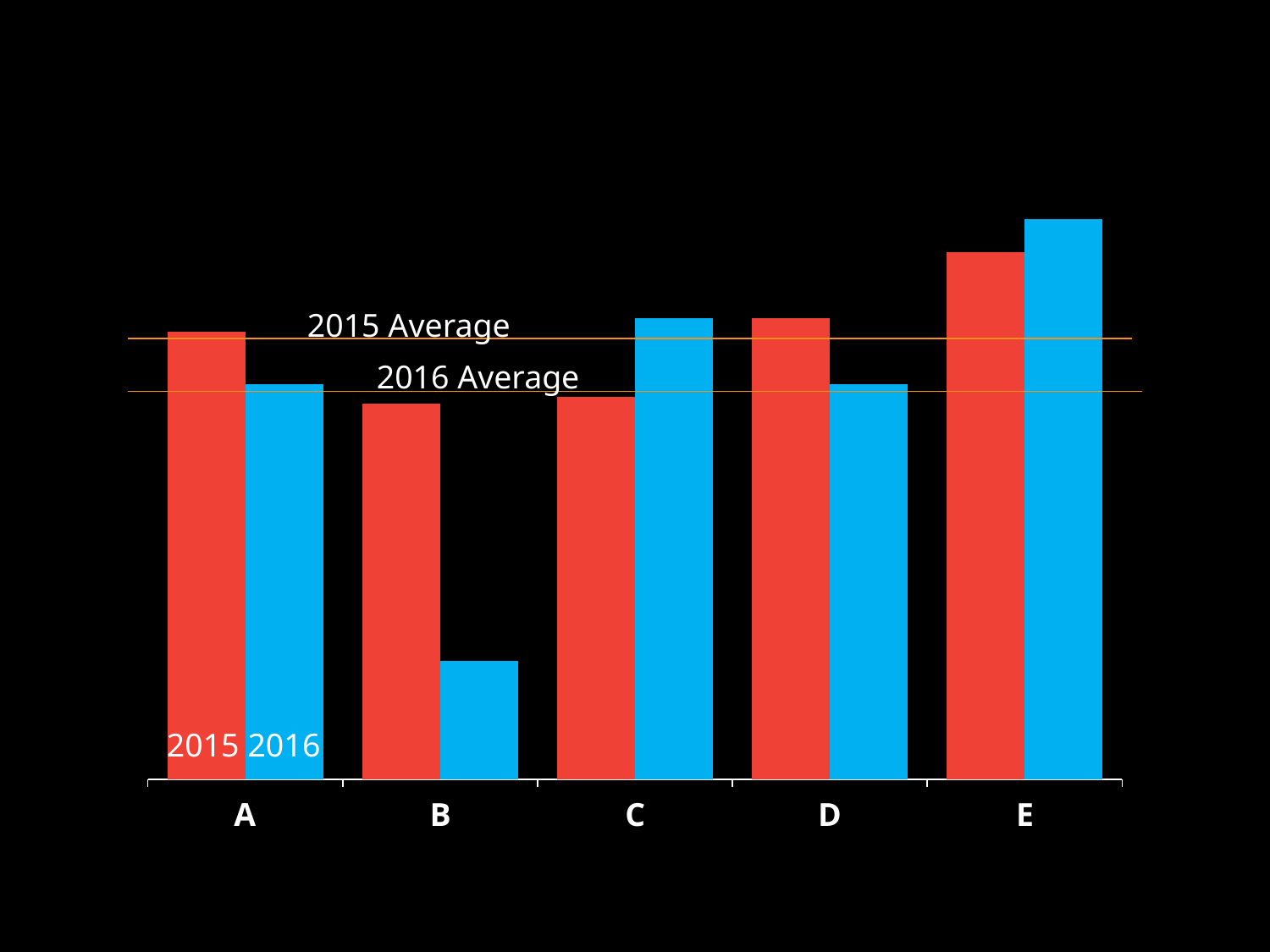
Which of the two horizontal average lines is higher on the chart, 2015 Average or 2016 Average? 2015 Average Which category has the highest 2016 value? E For category D, which is larger, the 2015 value or the 2016 value? 2015 Which category has the highest 2015 value? E For category E, which is larger, the 2015 value or the 2016 value? 2016 What colour are the bars for the 2015 series? red What kind of chart is shown on the slide? bar chart For category C, which is larger, the 2015 value or the 2016 value? 2016 How many series does the chart show? 2 Which category has the lowest 2016 value? B How many categories are shown on the x axis? 5